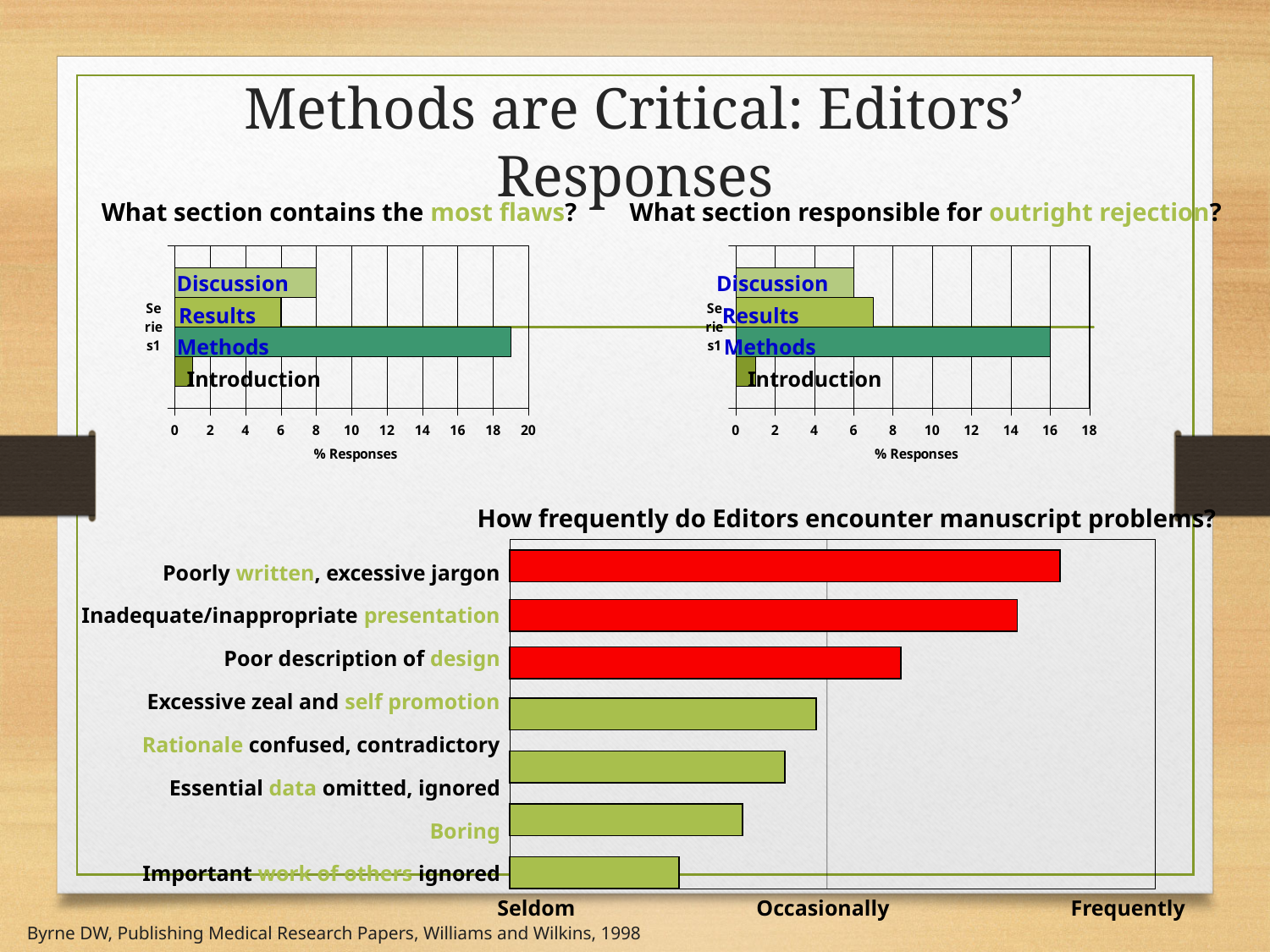
What is the x-axis label of the chart 'What section responsible for outright rejection?'? % Responses What type of chart is 'What section contains the most flaws?'? bar chart In the chart 'What section contains the most flaws?', is the value for Methods greater or less than 16? greater In the chart 'What section contains the most flaws?', which section has the lowest value? Introduction In the chart 'How frequently do Editors encounter manuscript problems?', which problem has the longest bar? Poorly written, excessive jargon How many sections are shown in the chart 'What section contains the most flaws?'? 4 In the chart 'How frequently do Editors encounter manuscript problems?', what are the three labels along the x axis? Seldom, Occasionally, Frequently In the chart 'What section contains the most flaws?', is the value for Discussion greater or less than 10? less In the chart 'What section contains the most flaws?', which section has the highest value? Methods In the chart 'What section responsible for outright rejection?', which section has the highest value? Methods In the chart 'What section responsible for outright rejection?', is the value for Methods greater or less than 14? greater In the chart 'What section responsible for outright rejection?', which is larger, Methods or Discussion? Methods